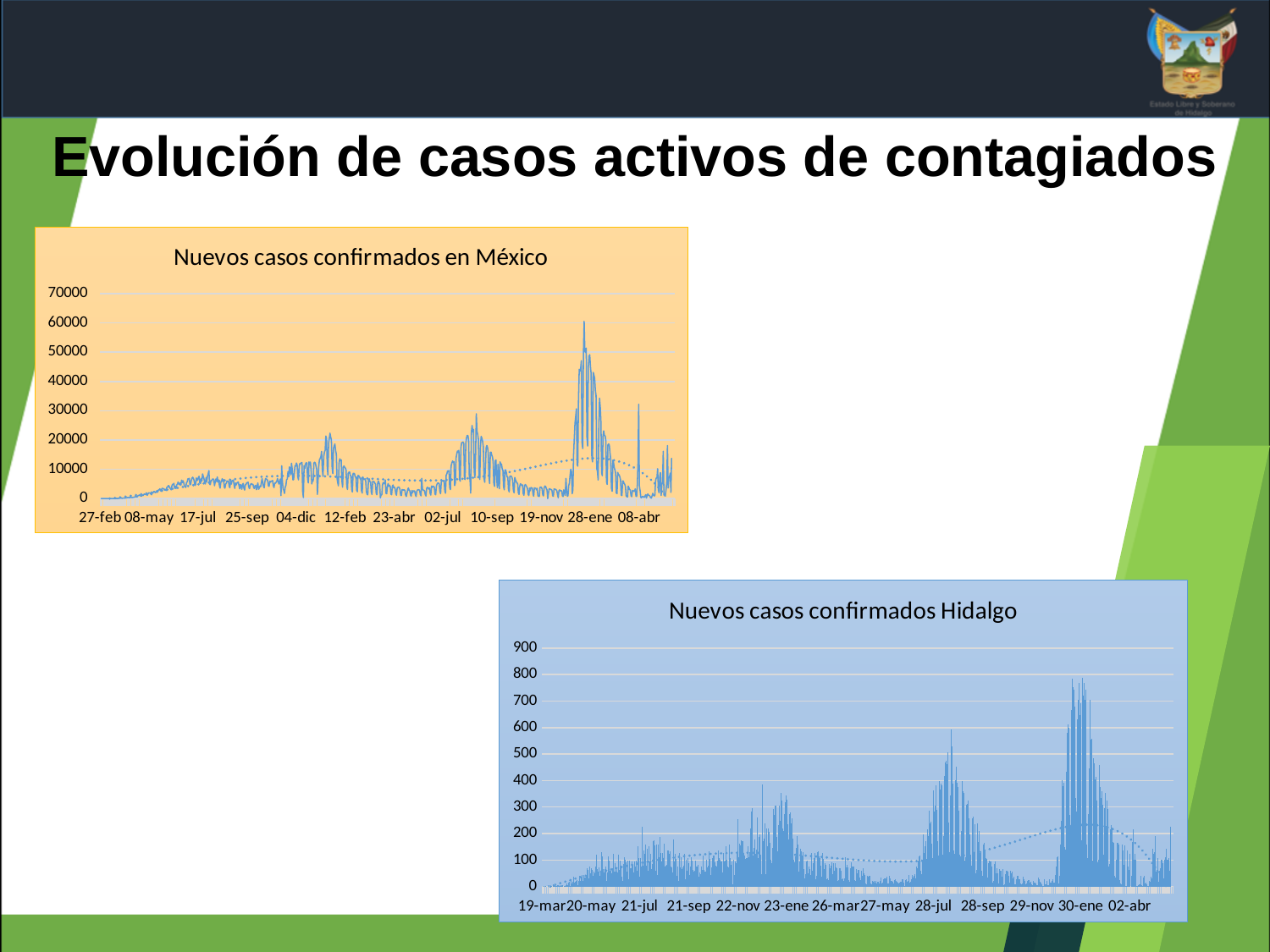
In the 'Nuevos casos confirmados Hidalgo' chart, which is larger: the peak near 30-ene or the peak near 27-may? the peak near 30-ene In the 'Nuevos casos confirmados Hidalgo' chart, is the peak near 27-may greater or less than 700? less In the 'Nuevos casos confirmados en México' chart, around which x-axis date does the highest peak occur? 28-ene In the 'Nuevos casos confirmados Hidalgo' chart, is the highest peak (near 30-ene) greater or less than 700? greater In the 'Nuevos casos confirmados en México' chart, is the peak of the first wave (near 12-feb) greater or less than 30000? less In the 'Nuevos casos confirmados en México' chart, which is larger: the peak near 28-ene or the peak near 12-feb? the peak near 28-ene What is the highest value shown on the y axis of the 'Nuevos casos confirmados Hidalgo' chart? 900 What is the first date label on the x axis of the 'Nuevos casos confirmados en México' chart? 27-feb What kind of chart is the 'Nuevos casos confirmados Hidalgo' chart? bar chart What kind of chart is the 'Nuevos casos confirmados en México' chart? line chart